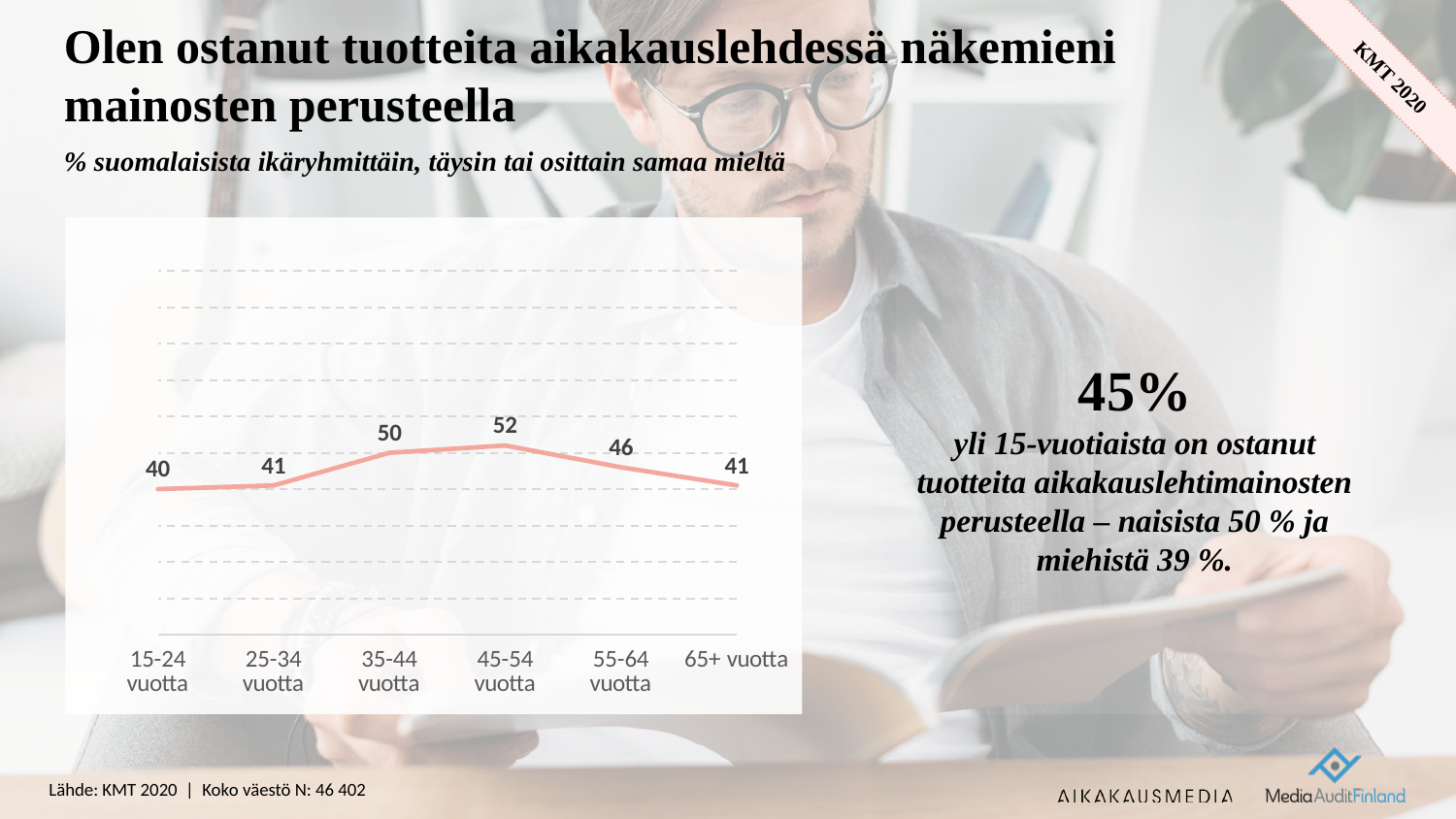
What is the difference between the values for 35-44 vuotta and 65+ vuotta? 9 What is the value for the 25-34 vuotta age group? 41 Which age group has the highest value? 45-54 vuotta Which age group has the lowest value? 15-24 vuotta What is the value for the 15-24 vuotta age group? 40 What is the difference between the values for 45-54 vuotta and 15-24 vuotta? 12 Do the values rise or fall from 15-24 vuotta to 45-54 vuotta? Rise What is the value for the 45-54 vuotta age group? 52 How many age groups are plotted on the chart? 6 What is the value for the 55-64 vuotta age group? 46 Which is larger, the value for 35-44 vuotta or the value for 55-64 vuotta? 35-44 vuotta What kind of chart is shown on the slide? Line chart